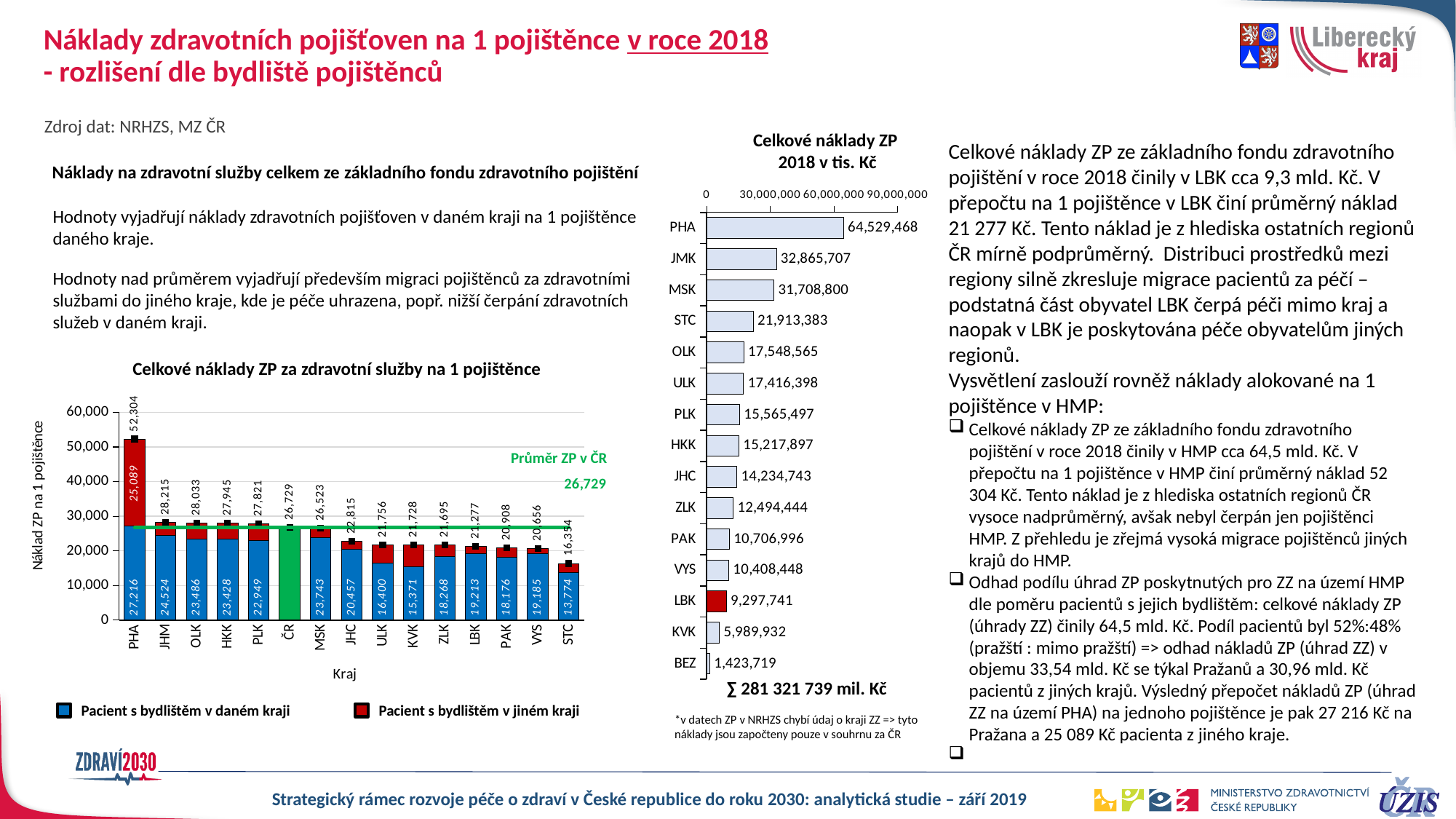
In the chart 'Celkové náklady ZP 2018 v tis. Kč', how many categories are shown? 15 What kind of chart is 'Celkové náklady ZP 2018 v tis. Kč'? bar chart In the chart 'Celkové náklady ZP 2018 v tis. Kč', what is the value for LBK? 9,297,741 In the chart 'Celkové náklady ZP za zdravotní služby na 1 pojištěnce', how many series does the legend list? 2 In the chart 'Celkové náklady ZP za zdravotní služby na 1 pojištěnce', which is larger: the total for JHM or the total for OLK? JHM In the chart 'Celkové náklady ZP za zdravotní služby na 1 pojištěnce', which region has the lowest total value? STC In the chart 'Celkové náklady ZP za zdravotní služby na 1 pojištěnce', what is the value of the 'Pacient s bydlištěm v daném kraji' series for LBK? 19,213 In the chart 'Celkové náklady ZP za zdravotní služby na 1 pojištěnce', what is the total value labelled for PHA? 52,304 In the chart 'Celkové náklady ZP 2018 v tis. Kč', is the value for STC greater or less than 30,000,000? less In the chart 'Celkové náklady ZP 2018 v tis. Kč', which region has the highest value? PHA In the chart 'Celkové náklady ZP 2018 v tis. Kč', what is the difference between the values for JMK and MSK? 1,156,907 In the chart 'Celkové náklady ZP 2018 v tis. Kč', which category has the lowest value? BEZ